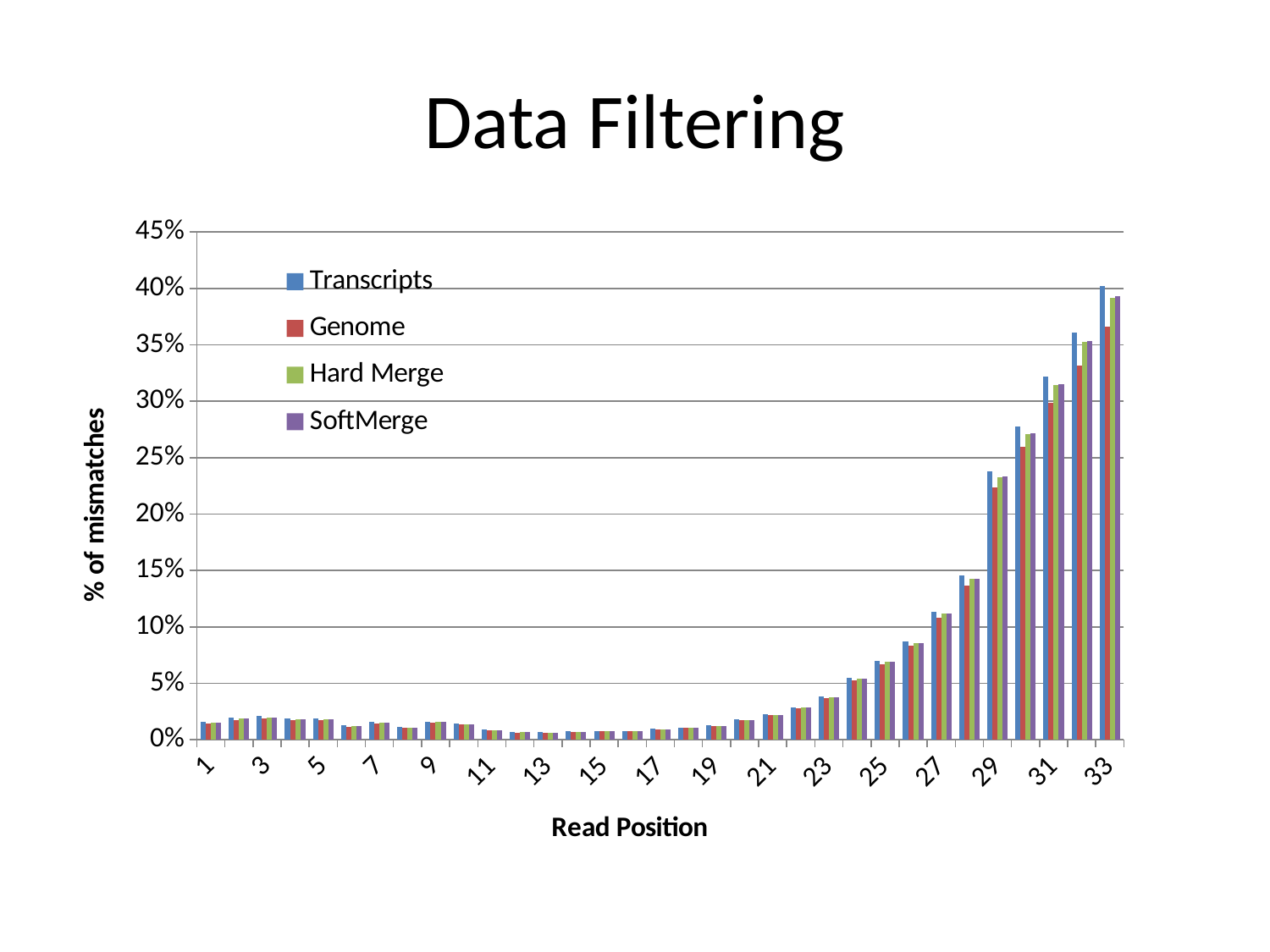
What kind of chart is shown on the slide? bar chart What is the label of the vertical axis? % of mismatches At read position 33, which is larger: the Transcripts value or the Genome value? Transcripts Is the Transcripts value at read position 33 greater or less than 35%? greater How many series does the legend list? 4 What is the title of the chart? Data Filtering Is the Genome value at read position 13 greater or less than 5%? less At which read position is the Transcripts value highest? 33 Do the values rise or fall from read position 21 to read position 33? rise Is the Transcripts value at read position 25 greater or less than 5%? greater At read position 29, which is larger: the Transcripts value or the Genome value? Transcripts